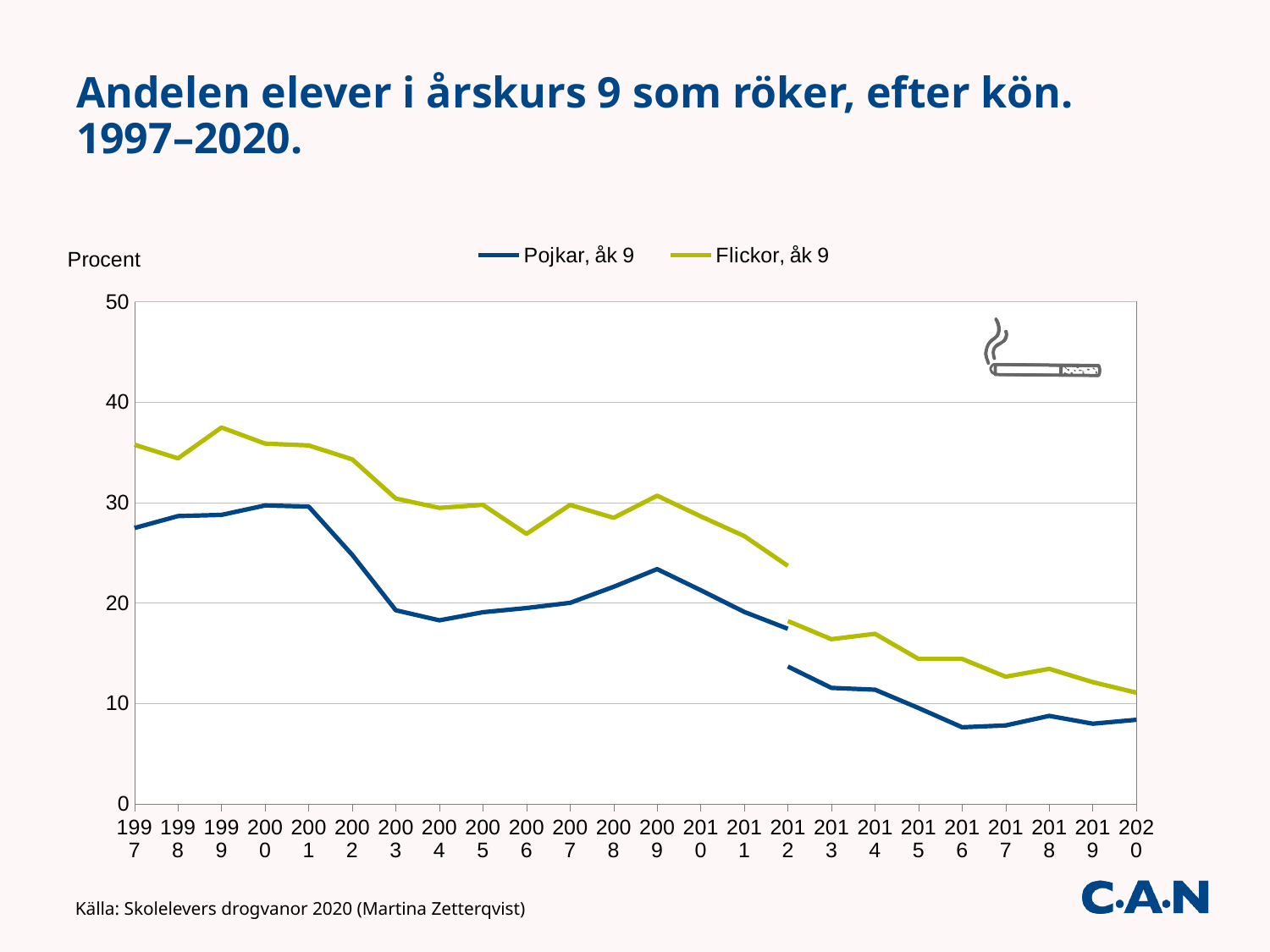
Is the value for Pojkar, åk 9 in 2016 greater or less than 10? less What kind of chart is shown on the slide? Line chart Is the value for Pojkar, åk 9 in 2009 greater or less than 20? greater How many years are shown on the x axis? 24 How many series does the legend list? 2 In 2000, which series has the higher value, Pojkar, åk 9 or Flickor, åk 9? Flickor, åk 9 What is the title of the chart? Andelen elever i årskurs 9 som röker, efter kön. 1997–2020. What are the two series named in the legend? Pojkar, åk 9 and Flickor, åk 9 Is the value for Flickor, åk 9 in 1997 greater or less than 30? greater In which year does Flickor, åk 9 reach its highest value? 1999 Overall, do the values for Pojkar, åk 9 rise or fall from 1997 to 2020? Fall